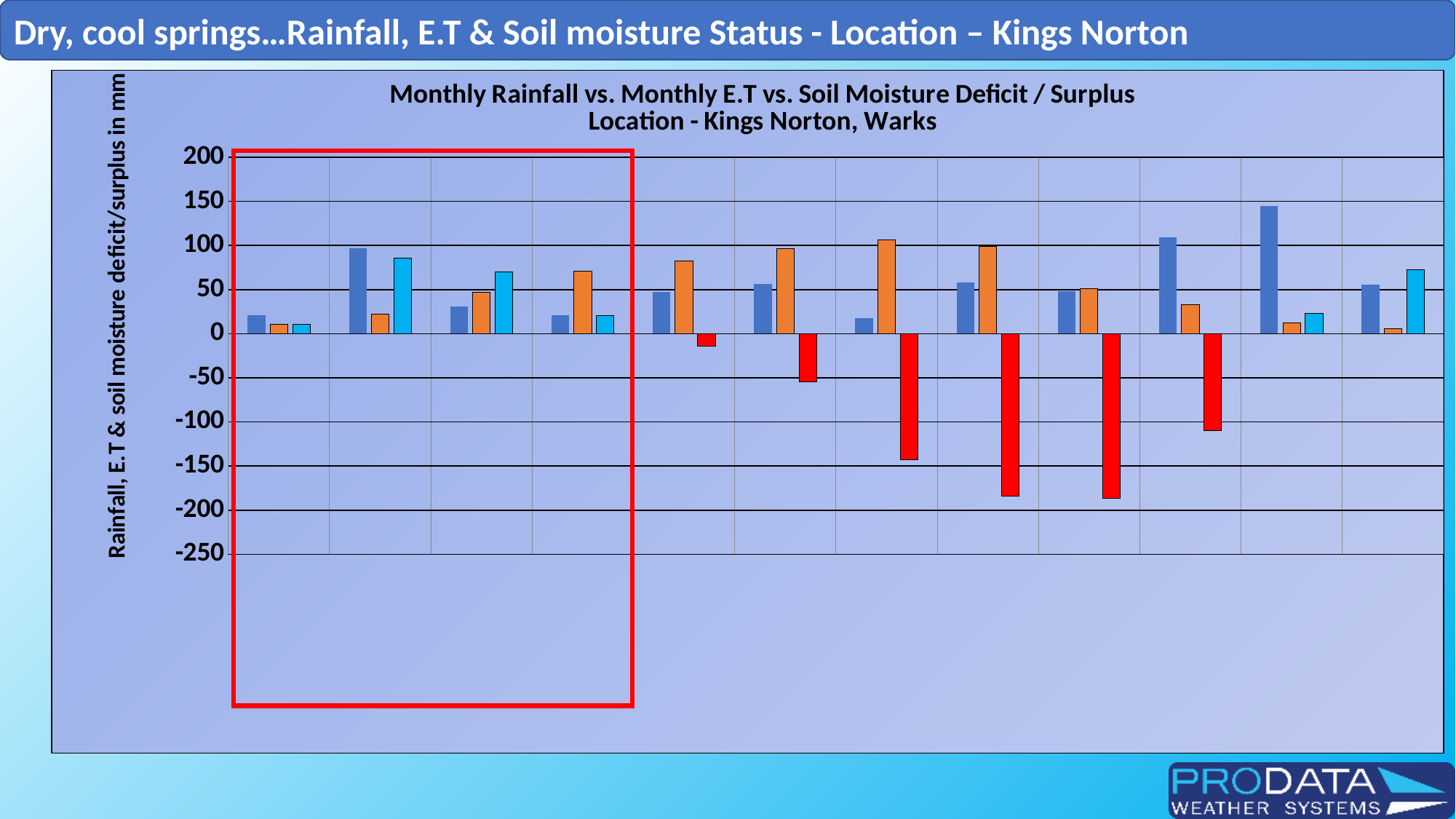
Are the red bars above or below zero on the chart? below Is the tallest orange bar greater or less than 100? greater What is the lowest value shown on the vertical axis? -250 How many groups of bars are plotted along the x axis? 12 How many red bars extend below zero on the chart? 6 Is the tallest dark blue bar greater or less than 100? greater Is the lowest red bar greater or less than -150? less What is the highest value shown on the vertical axis? 200 What is the title of the chart? Monthly Rainfall vs. Monthly E.T vs. Soil Moisture Deficit / Surplus Location - Kings Norton, Warks What is the label on the vertical axis of the chart? Rainfall, E.T & soil moisture deficit/surplus in mm What kind of chart is shown on the slide? bar chart